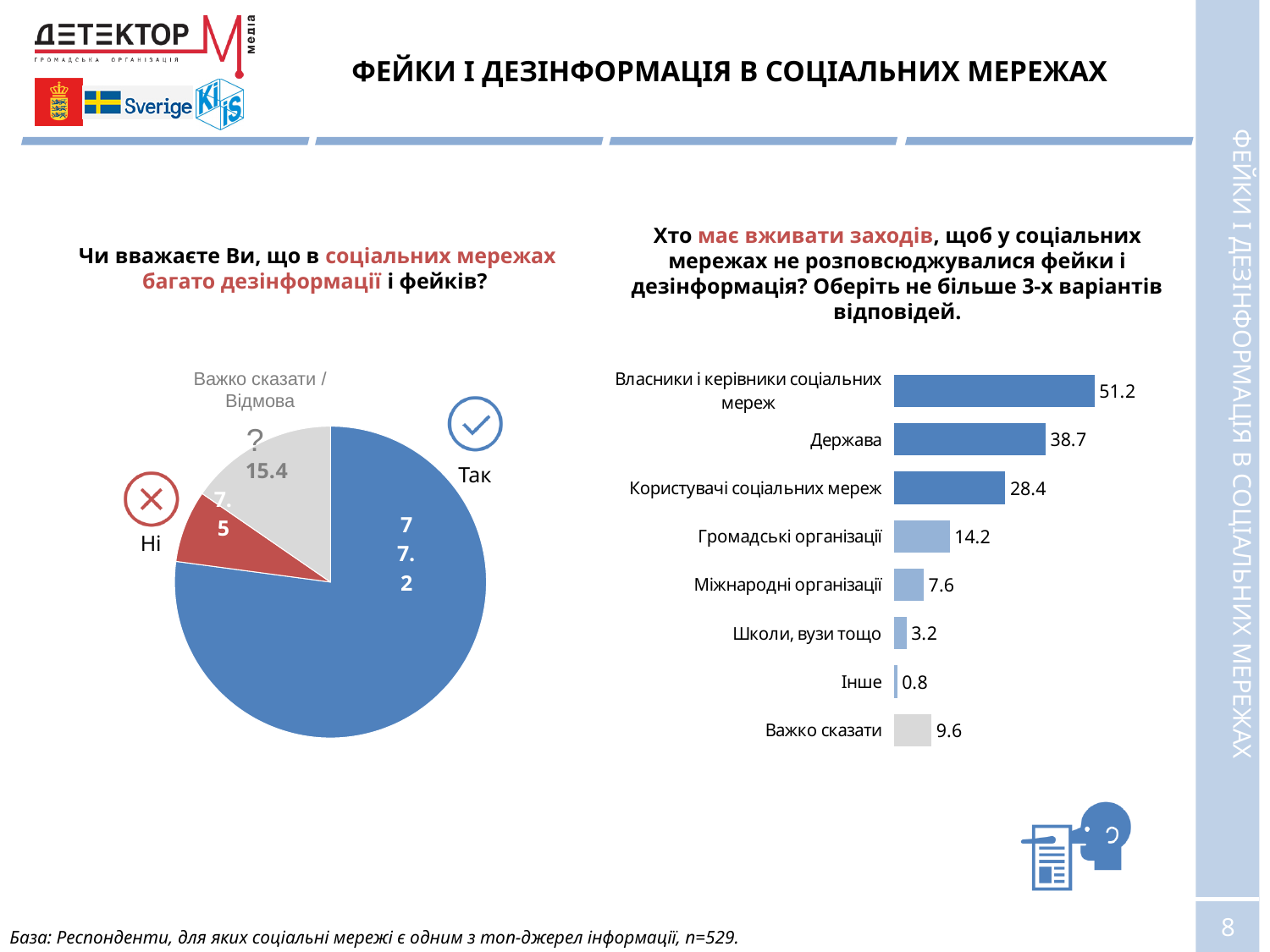
In the bar chart on the right, which is larger: "Міжнародні організації" or "Важко сказати"? Важко сказати In the bar chart on the right, what is the difference between the values for "Держава" and "Користувачі соціальних мереж"? 10.3 In the pie chart on the left, which category has the largest share? Так How many slices does the pie chart on the left have? 3 In the bar chart on the right, what is the value for "Школи, вузи тощо"? 3.2 In the pie chart on the left, what is the value for "Так"? 77.2 How many categories are shown in the bar chart on the right? 8 In the bar chart on the right, which category has the highest value? Власники і керівники соціальних мереж What kind of chart is the chart on the left of the slide? Pie chart In the bar chart on the right, what is the value for "Держава"? 38.7 In the bar chart on the right, which category has the lowest value? Інше In the pie chart on the left, what is the value for "Важко сказати / Відмова"? 15.4